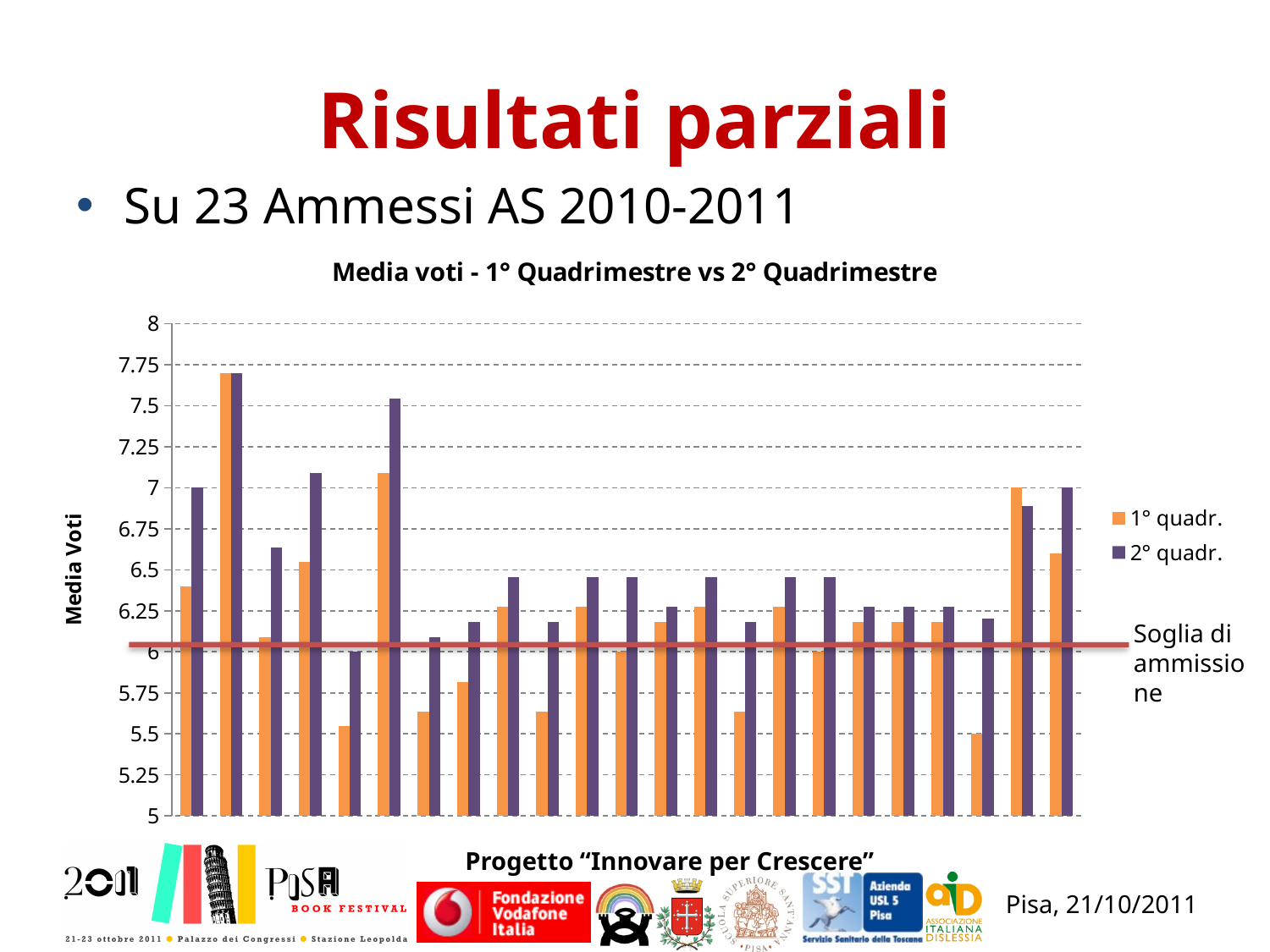
What are the two series named in the legend? 1° quadr. and 2° quadr. Is the shortest 1° quadr. bar greater or less than 5.75? less What type of chart is shown on the slide? bar chart Is the tallest 1° quadr. bar greater or less than 7.5? greater What is the title of the chart? Media voti - 1° Quadrimestre vs 2° Quadrimestre How many series does the chart legend list? 2 Is the shortest 2° quadr. bar greater or less than 6.25? less What is the maximum value shown on the vertical axis? 8 What is the minimum value shown on the vertical axis? 5 How many pairs of bars (students) are plotted in the chart? 23 What is the label of the vertical axis? Media Voti